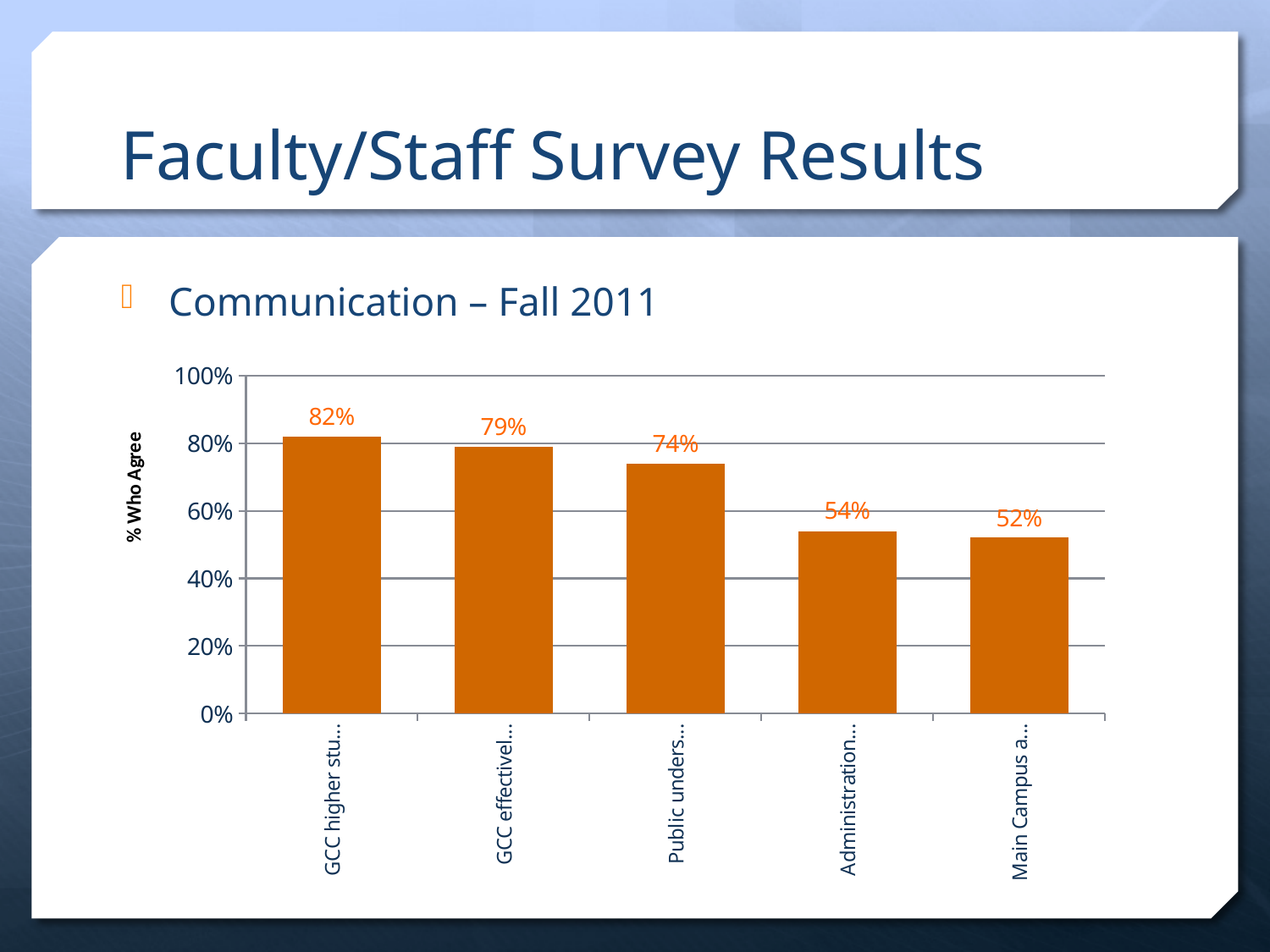
Which is larger: the value for "GCC effectivel..." or the value for "Public unders..."? GCC effectivel... (79%) How many bars are shown in the chart? 5 What type of chart is shown on the slide? Bar chart What is the value of the first (leftmost) bar in the chart? 82% What is the label of the vertical axis? % Who Agree Which bar has the lowest value in the chart? The last bar (Main Campus a...), 52% Is the value for "Administration..." greater or less than 60%? less What is the value of the bar labelled "Main Campus a..."? 52% Which bar has the highest value in the chart? The first bar (GCC higher stu...), 82% What is the value of the bar labelled "Administration..."? 54% What is the value of the bar labelled "Public unders..."? 74% What is the difference between the first bar (82%) and the last bar (52%)? 30%